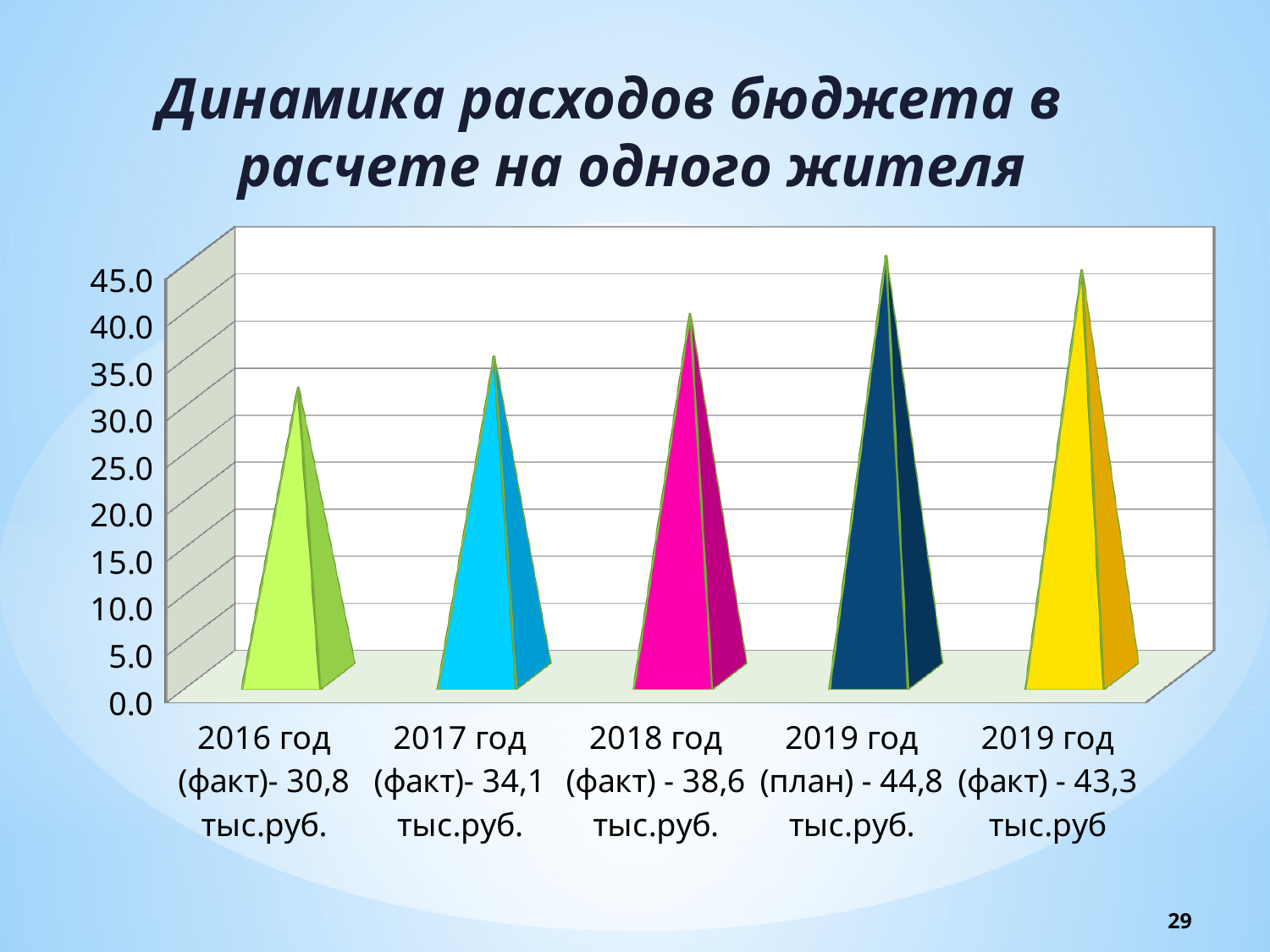
Which category has the highest value? 2019 год (план) How many categories are shown on the chart? 5 Which category has the lowest value? 2016 год (факт) What is the difference between the 2017 год (факт) value and the 2016 год (факт) value? 3,3 тыс.руб. What is the difference between the 2019 год (план) value and the 2019 год (факт) value? 1,5 тыс.руб. What kind of chart is shown on the slide? bar chart Do the values rise or fall from 2016 год (факт) to 2019 год (план)? rise What is the budget expenditure per resident for 2016 год (факт)? 30,8 тыс.руб. What is the value shown for 2019 год (план)? 44,8 тыс.руб. Is the value for 2018 год (факт) greater or less than 35.0? greater What is the value shown for 2018 год (факт)? 38,6 тыс.руб. Which is larger: the value for 2018 год (факт) or the value for 2017 год (факт)? 2018 год (факт)